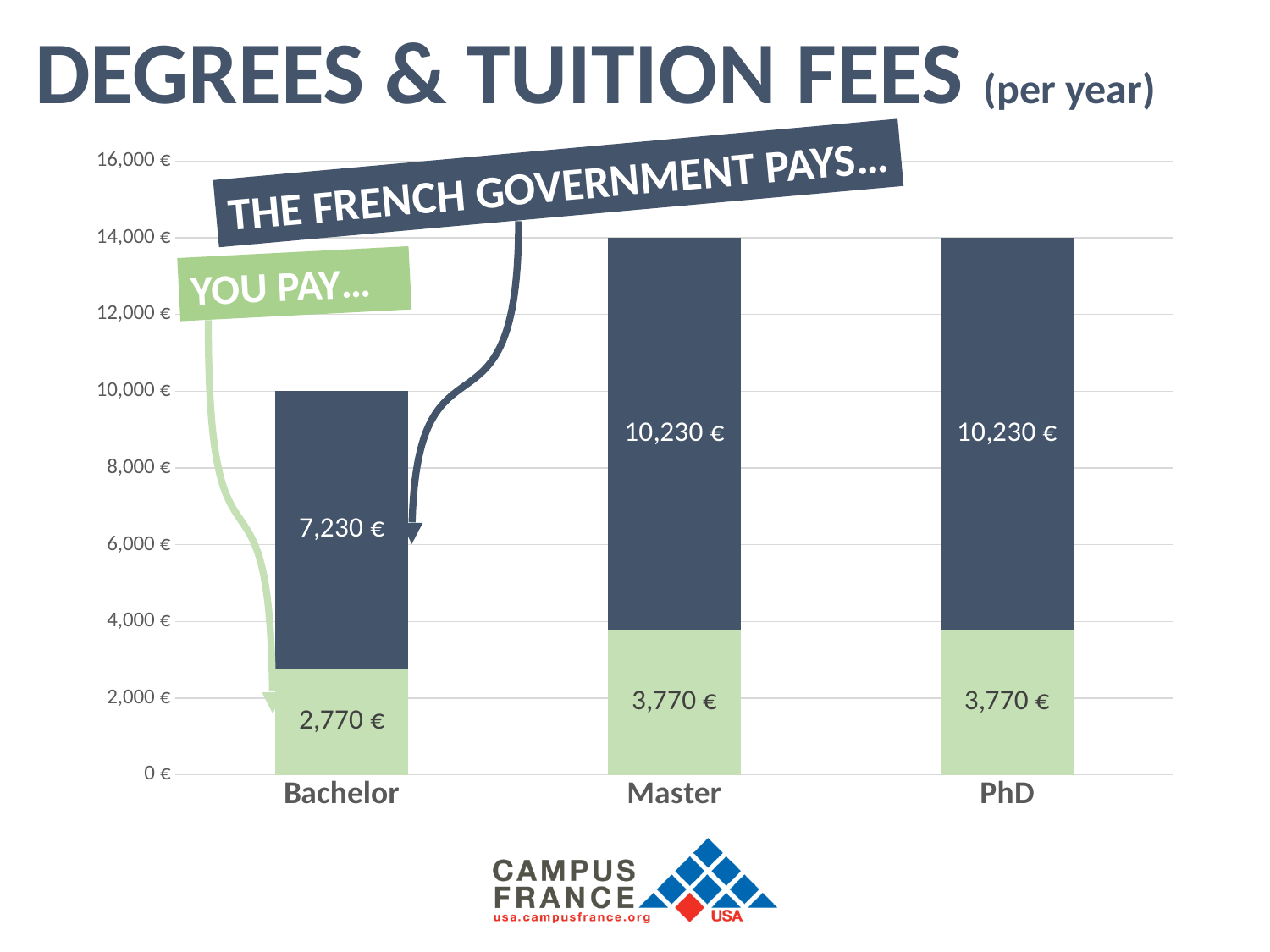
Which degree has the lowest total tuition fee per year? Bachelor How much does the French government pay per year for a Master degree? 10,230 € What is the difference between what the student pays for a Master and what the student pays for a Bachelor? 1,000 € What is the total tuition fee per year for a Master degree (student plus government)? 14,000 € What kind of chart is shown on the slide? Stacked bar chart Which colour represents the amount the student pays? Light green How much does the French government pay per year for a Bachelor degree? 7,230 € Is the government contribution for a Bachelor degree larger or smaller than the government contribution for a PhD? Smaller How many degree categories are shown on the x axis? 3 What is the total tuition fee per year for a Bachelor degree (student plus government)? 10,000 € How much does the student pay per year for a Bachelor degree? 2,770 € How much does the student pay per year for a PhD? 3,770 €